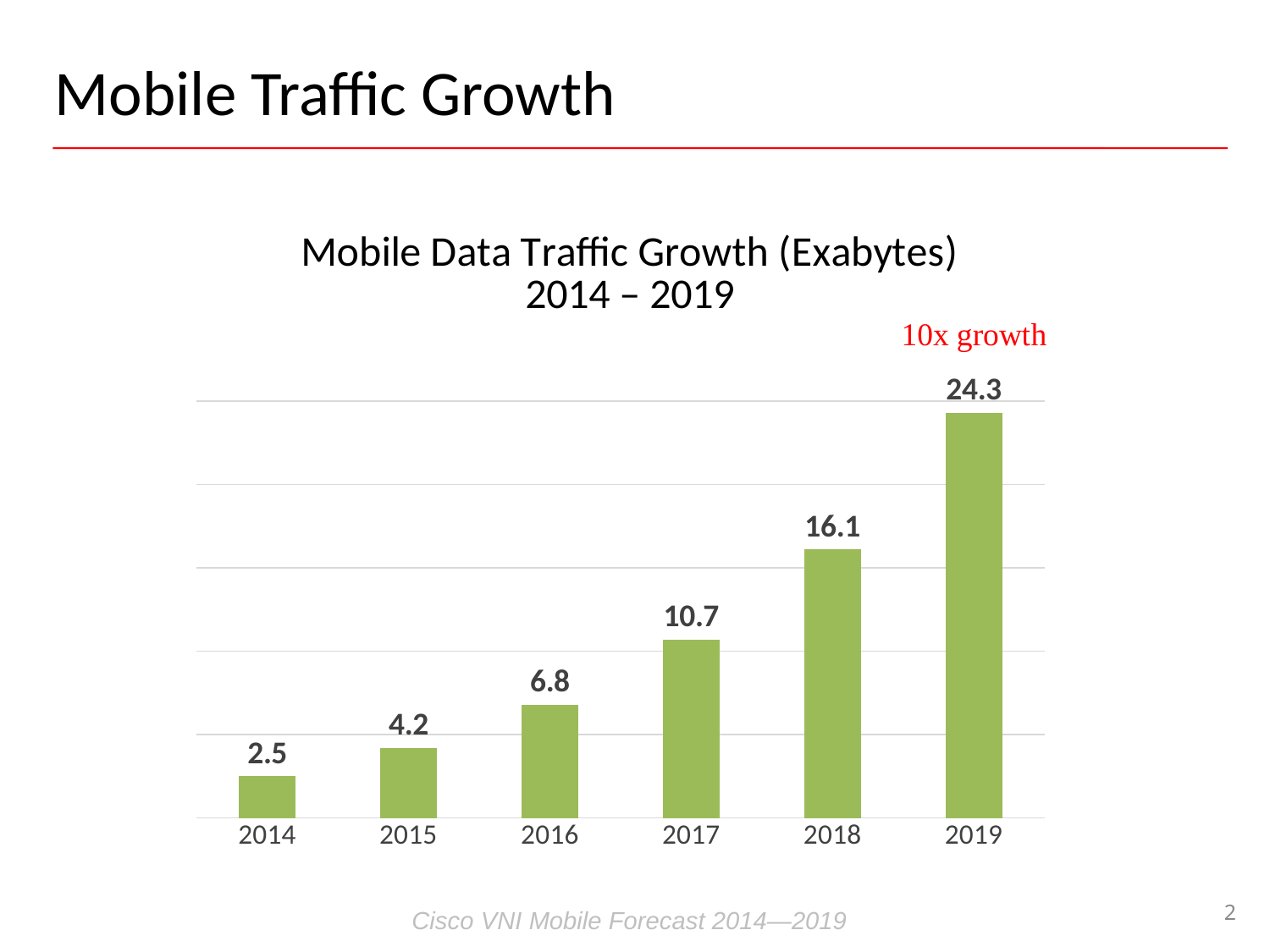
What is the mobile data traffic value for 2019? 24.3 What is the difference between the values for 2016 and 2015? 2.6 What is the title of the chart? Mobile Data Traffic Growth (Exabytes) 2014 – 2019 How many years are shown on the x axis? 6 Which is larger, the value for 2017 or the value for 2016? 2017 Do the values rise or fall from 2014 to 2019? Rise Which year has the highest mobile data traffic? 2019 What is the mobile data traffic value for 2017? 10.7 What kind of chart is shown on the slide? Bar chart Which year has the lowest mobile data traffic? 2014 What is the difference between the values for 2019 and 2018? 8.2 What is the mobile data traffic value for 2014? 2.5